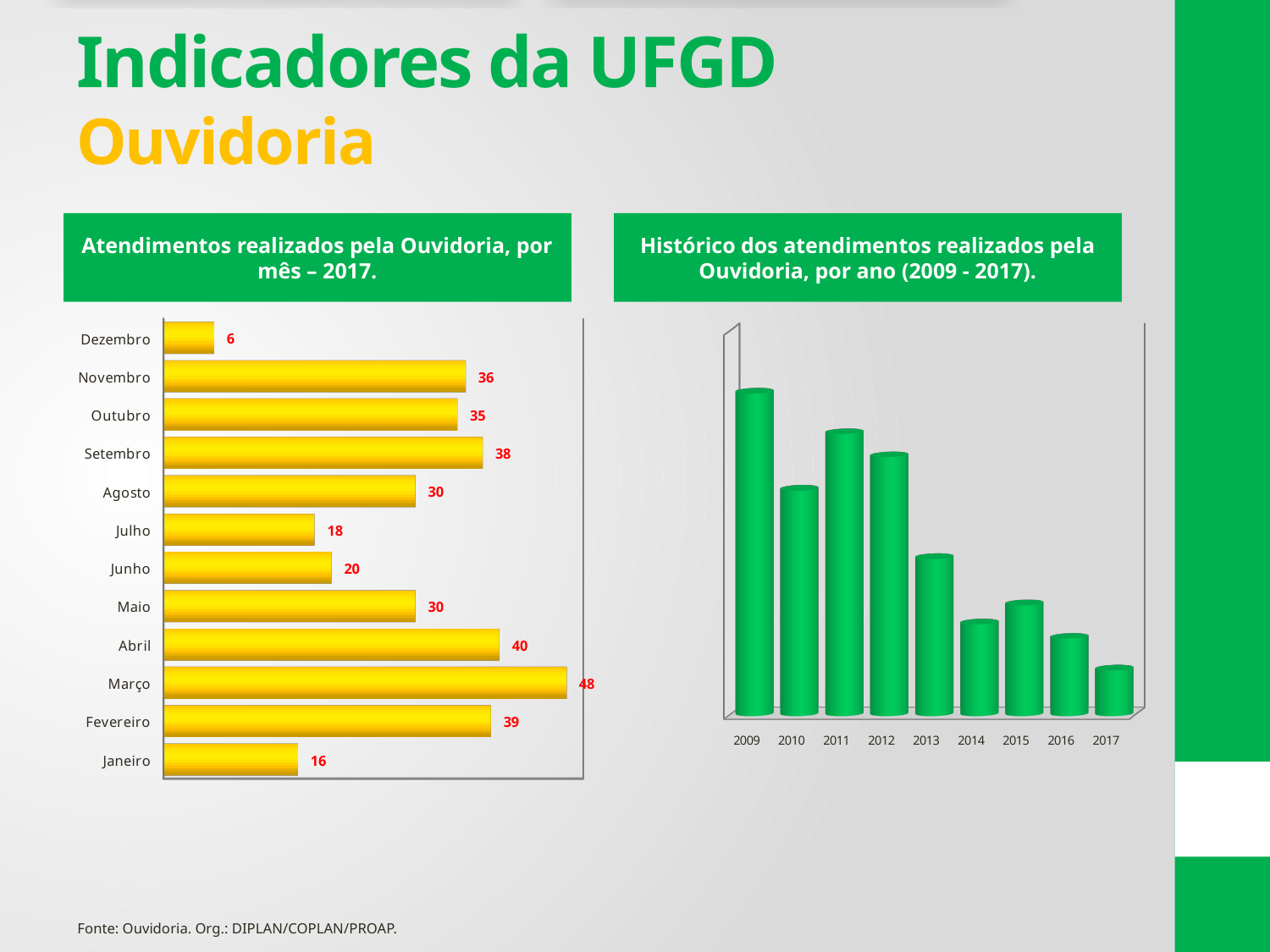
In the chart 'Histórico dos atendimentos realizados pela Ouvidoria, por ano (2009 - 2017)', which is larger, the bar for 2010 or the bar for 2011? 2011 How many years are shown in the chart 'Histórico dos atendimentos realizados pela Ouvidoria, por ano (2009 - 2017)'? 9 In the chart 'Atendimentos realizados pela Ouvidoria, por mês – 2017', which is larger, the value for Novembro or the value for Outubro? Novembro What kind of chart is 'Atendimentos realizados pela Ouvidoria, por mês – 2017'? Bar chart In the chart 'Atendimentos realizados pela Ouvidoria, por mês – 2017', what is the value for Setembro? 38 In the chart 'Atendimentos realizados pela Ouvidoria, por mês – 2017', which month has the highest value? Março In the chart 'Histórico dos atendimentos realizados pela Ouvidoria, por ano (2009 - 2017)', which year has the highest bar? 2009 In the chart 'Atendimentos realizados pela Ouvidoria, por mês – 2017', what is the difference between the values for Abril and Janeiro? 24 In the chart 'Histórico dos atendimentos realizados pela Ouvidoria, por ano (2009 - 2017)', which year has the lowest bar? 2017 In the chart 'Atendimentos realizados pela Ouvidoria, por mês – 2017', what is the value for Março? 48 In the chart 'Atendimentos realizados pela Ouvidoria, por mês – 2017', which month has the lowest value? Dezembro How many months are shown in the chart 'Atendimentos realizados pela Ouvidoria, por mês – 2017'? 12